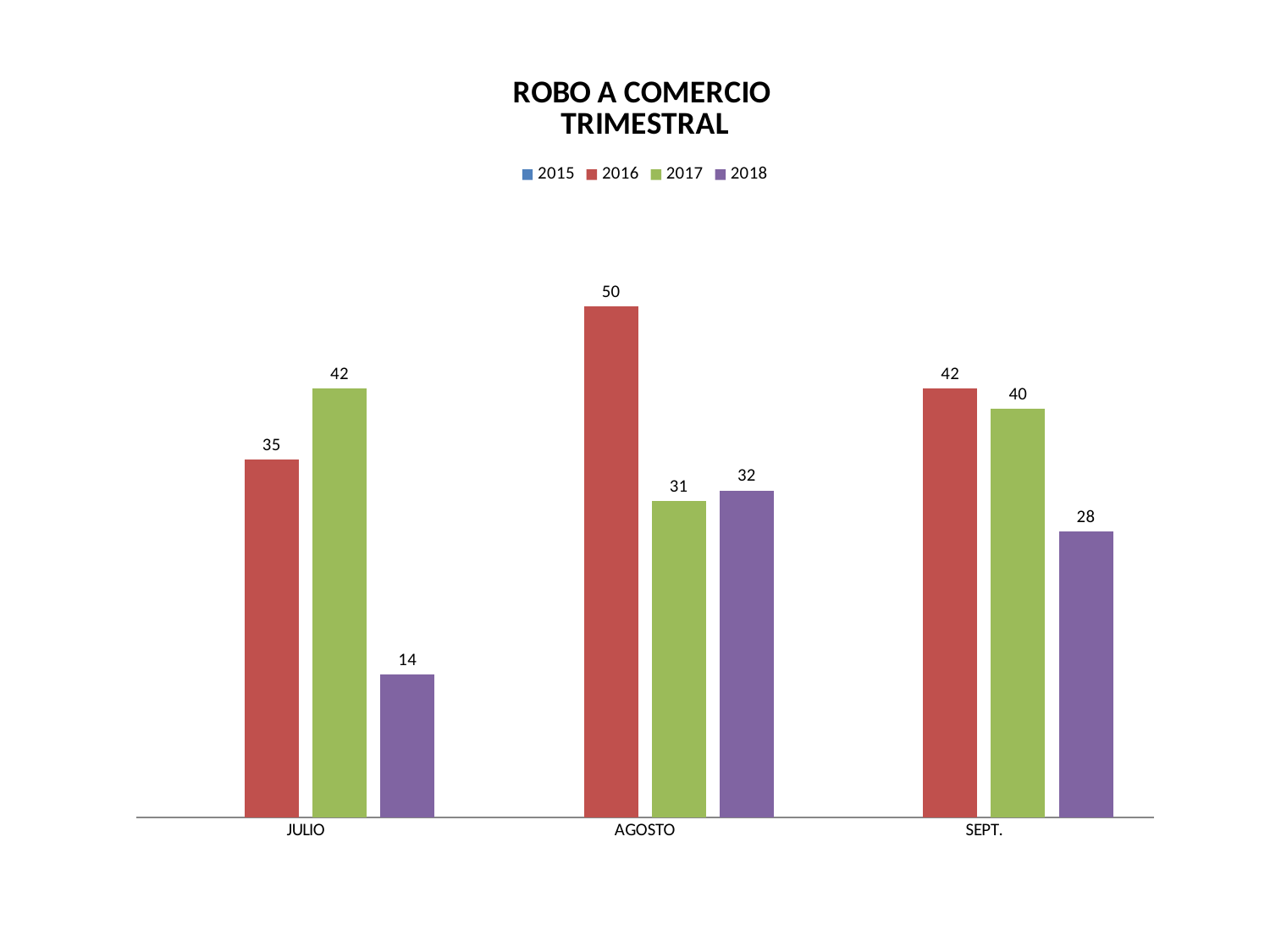
What is the value for 2016 in AGOSTO? 50 What kind of chart is shown on the slide? Bar chart What is the title of the chart? ROBO A COMERCIO TRIMESTRAL Which month has the lowest value for the 2018 series? JULIO What is the value for 2017 in SEPT.? 40 How many series does the legend list? 4 What is the value for 2018 in JULIO? 14 Does the 2018 series rise or fall from AGOSTO to SEPT.? Fall How many months are shown on the x axis? 3 What is the difference between the 2016 and 2017 values in AGOSTO? 19 Which month has the highest value for the 2016 series? AGOSTO Which is larger in JULIO, the 2016 value or the 2017 value? 2017